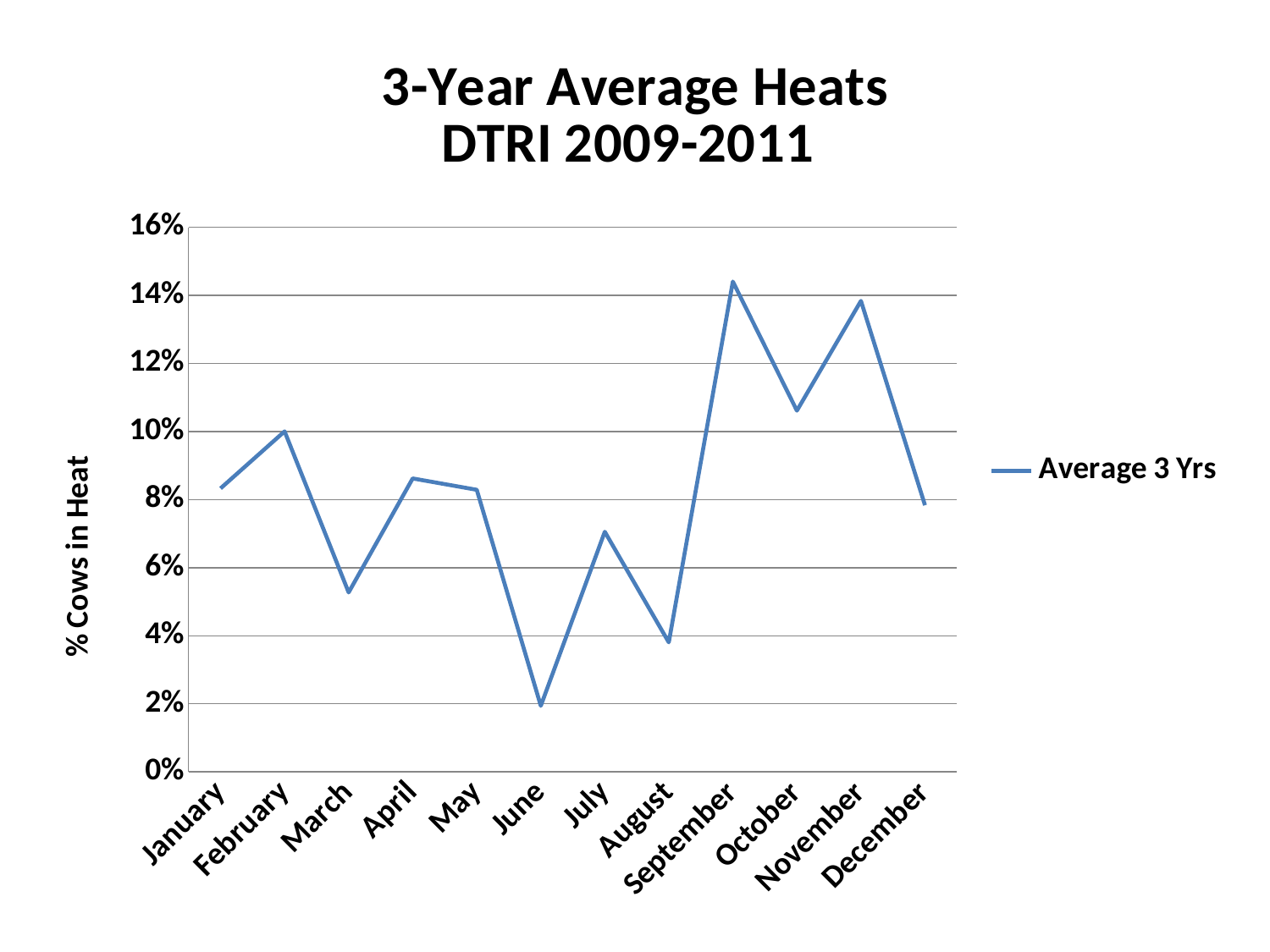
Is the value for June greater or less than 4%? less Is the value for September greater or less than 12%? greater What is the label on the y axis? % Cows in Heat How many series does the legend list? 1 How many months are plotted along the x axis? 12 Is the value for October greater or less than 10%? greater Which month has the highest value for Average 3 Yrs? September What kind of chart is shown on the slide? line chart Which month has the lowest value for Average 3 Yrs? June Do the values rise or fall from August to September? rise Which is larger, the value for July or the value for March? July